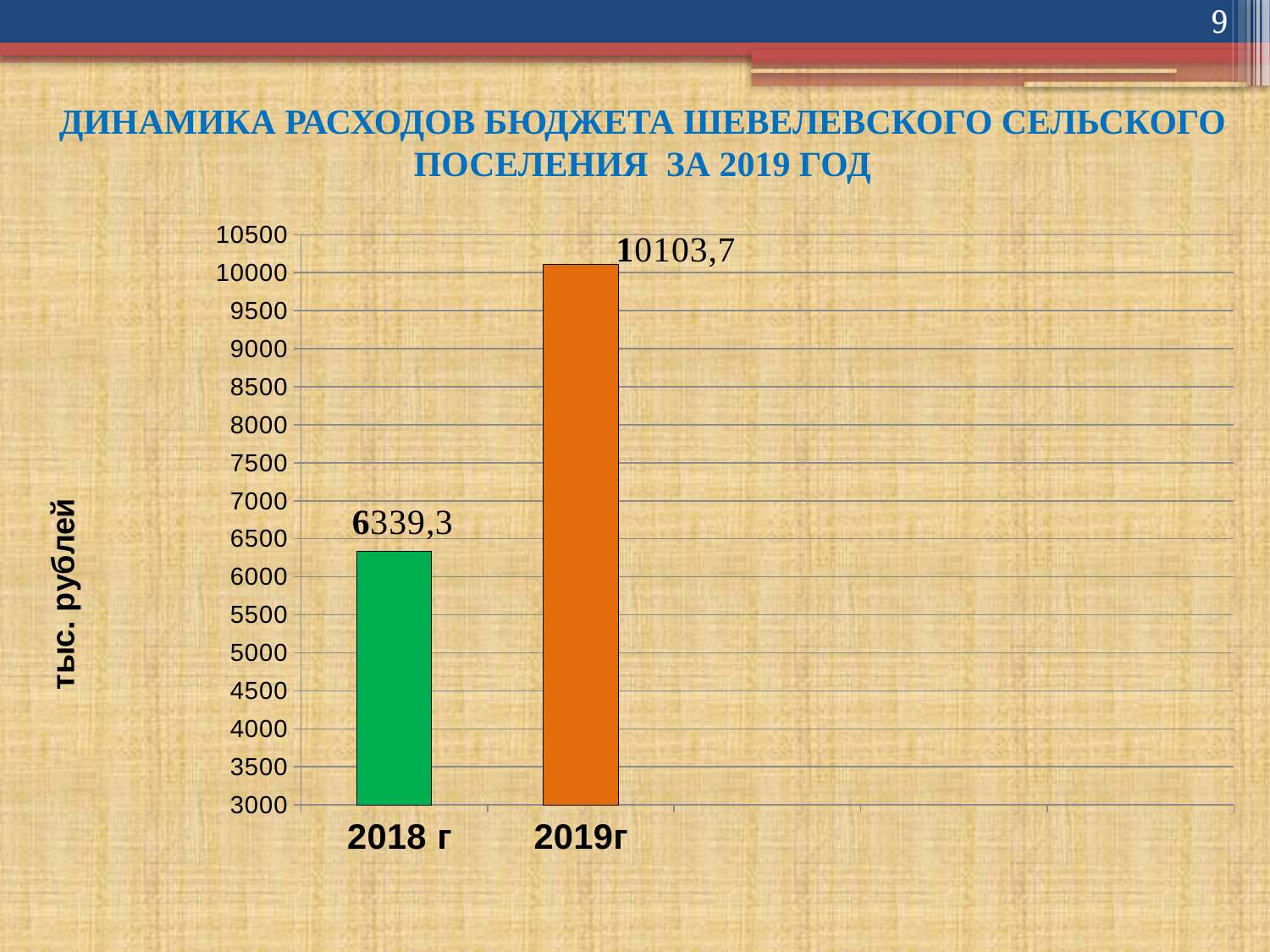
What is the difference between the values for 2019г and 2018 г? 3764,4 What is the value for 2018 г? 6339,3 What is the label of the vertical axis? тыс. рублей What is the value for 2019г? 10103,7 What kind of chart is shown on the slide? bar chart How many bars are shown in the chart? 2 Is the value for 2019г greater or less than 10000? greater Which is larger, the value for 2018 г or the value for 2019г? 2019г Which year has the highest value? 2019г Is the value for 2018 г greater or less than 6500? less Which year has the lowest value? 2018 г Do the values rise or fall from 2018 г to 2019г? rise